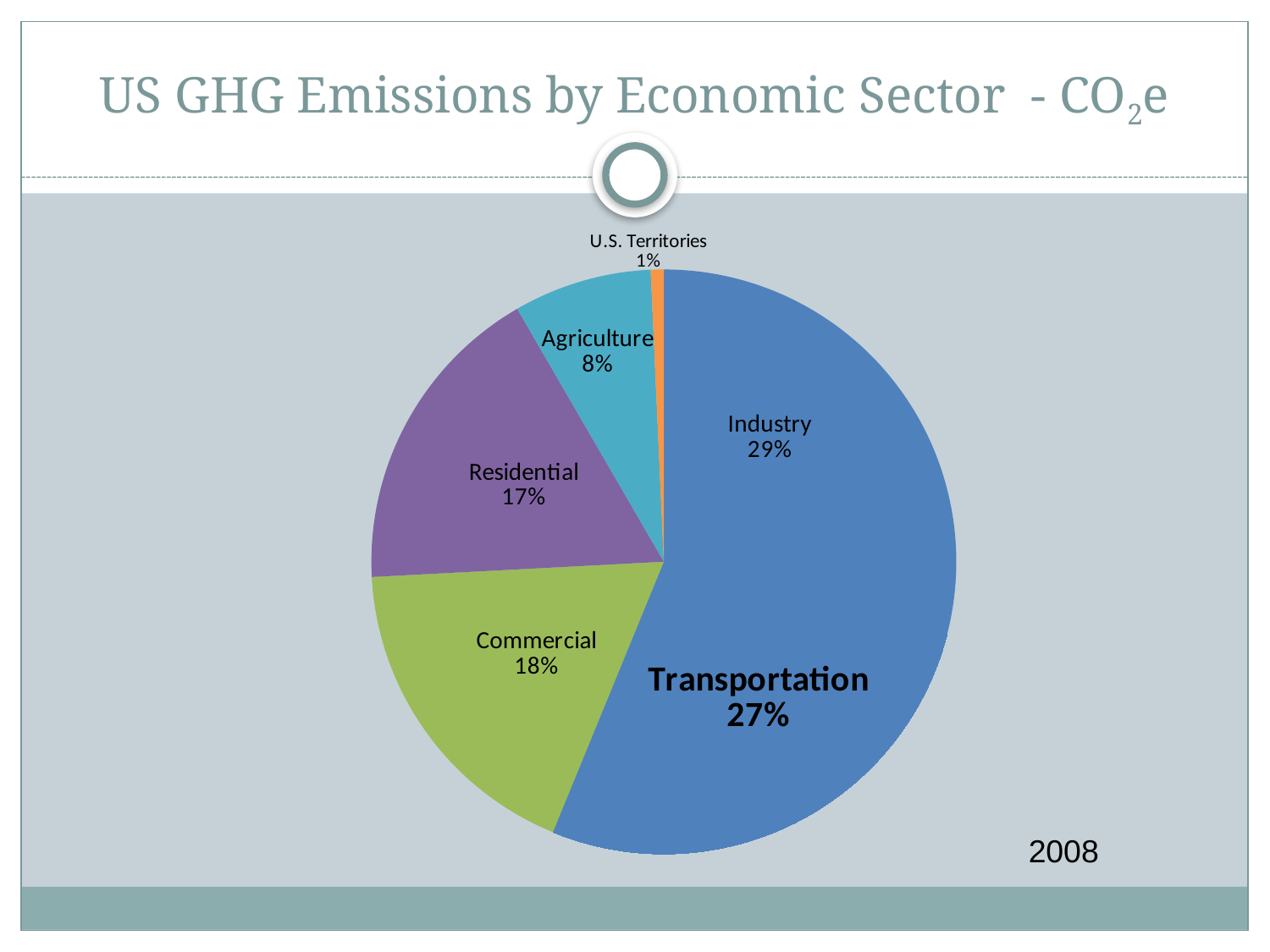
What share of US GHG emissions does Residential account for? 17% How many economic sectors are shown in the pie chart? 6 What kind of chart is shown on the slide? Pie chart What is the difference in percentage points between the Industry and Transportation shares? 2% Which has a larger share of US GHG emissions, Commercial or Residential? Commercial What share of US GHG emissions does Transportation account for? 27% Which economic sector has the smallest share of US GHG emissions? U.S. Territories What is the difference in percentage points between the Commercial and Agriculture shares? 10% What share of US GHG emissions does Industry account for? 29% What year does the chart's data refer to? 2008 Which economic sector has the largest share of US GHG emissions? Industry What share of US GHG emissions does Agriculture account for? 8%